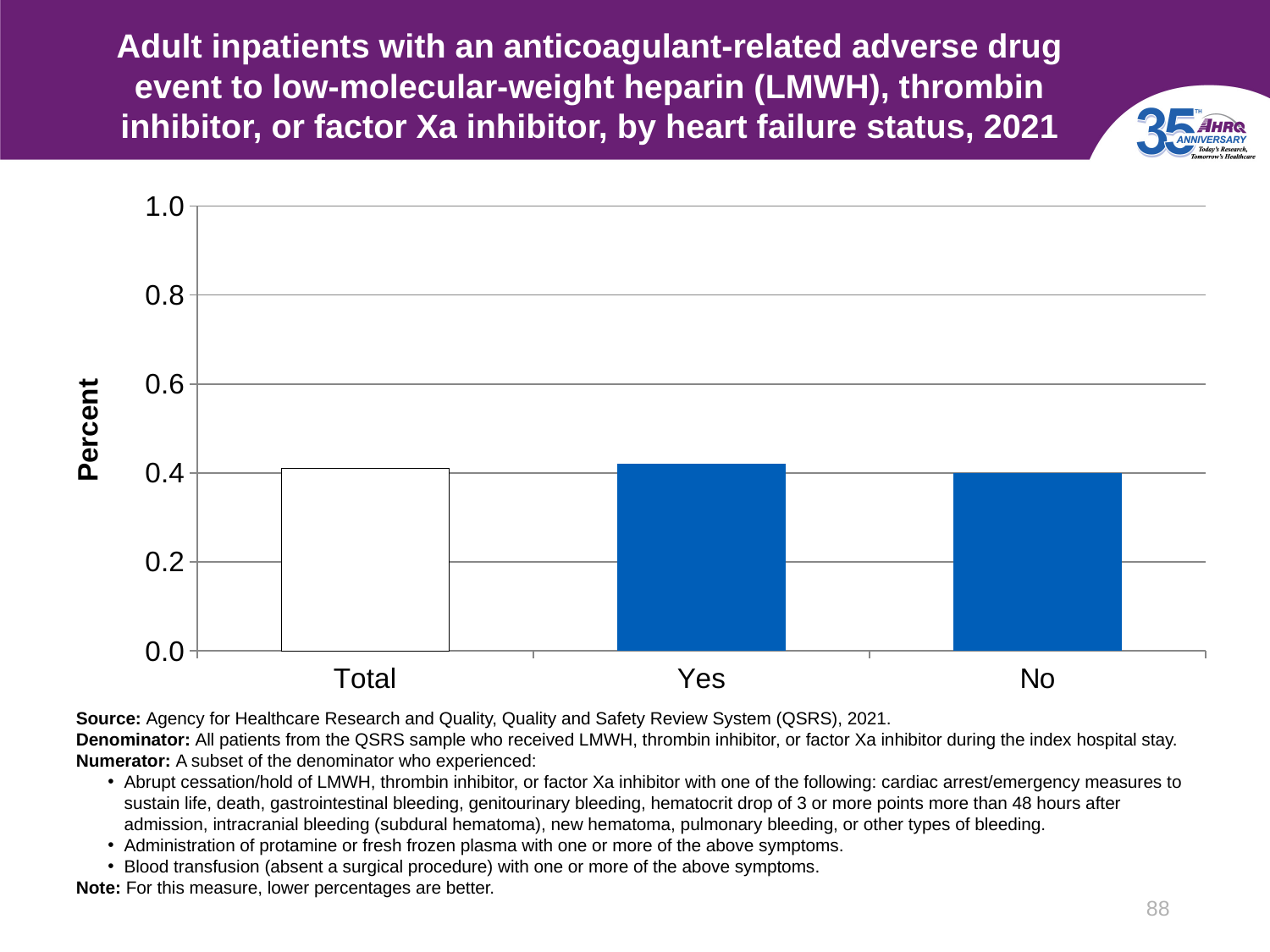
What kind of chart is shown on the slide? bar chart How many categories are shown on the x axis of the chart? 3 Which bar in the chart is unfilled (white) rather than blue? Total Is the value for No greater or less than 0.6? less Is the value for No greater or less than 0.2? greater What is the label on the vertical axis of the chart? Percent What is the highest value shown on the vertical axis of the chart? 1.0 Is the value for Total greater or less than 0.2? greater